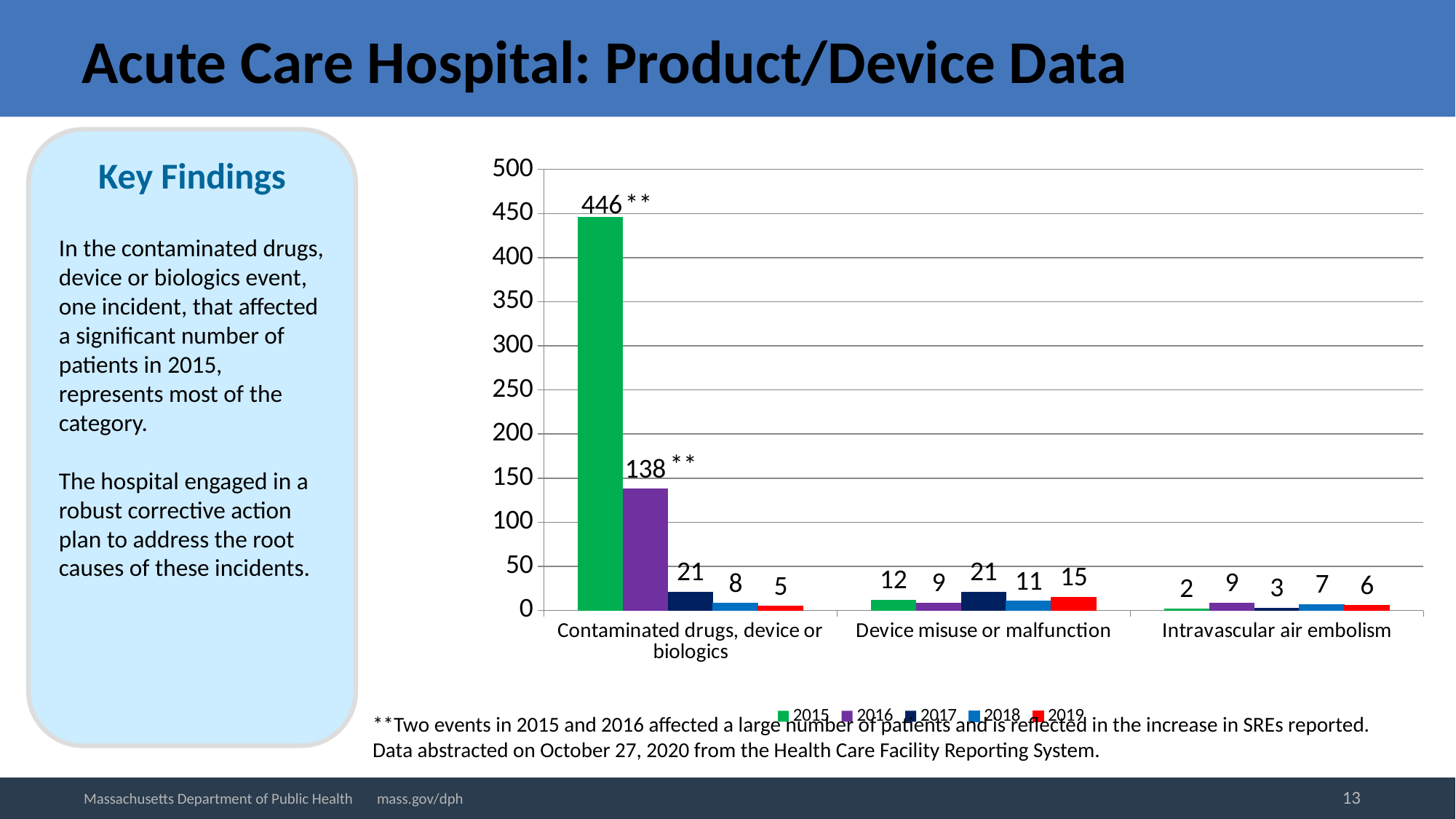
How many event categories are shown on the x axis? 3 Is the 2015 value for Contaminated drugs, device or biologics greater or less than 400? greater What kind of chart is shown on the slide? Bar chart What is the value for 2019 in the Device misuse or malfunction category? 15 Which year has the highest value in the Device misuse or malfunction category? 2017 What is the value for 2015 in the Contaminated drugs, device or biologics category? 446 What is the difference between the 2015 and 2016 values in the Contaminated drugs, device or biologics category? 308 Which is larger: the 2016 value for Device misuse or malfunction or the 2016 value for Intravascular air embolism? They are equal (9) What is the value for 2016 in the Contaminated drugs, device or biologics category? 138 How many series does the legend list? 5 Which year has the lowest value in the Intravascular air embolism category? 2015 What is the value for 2018 in the Intravascular air embolism category? 7